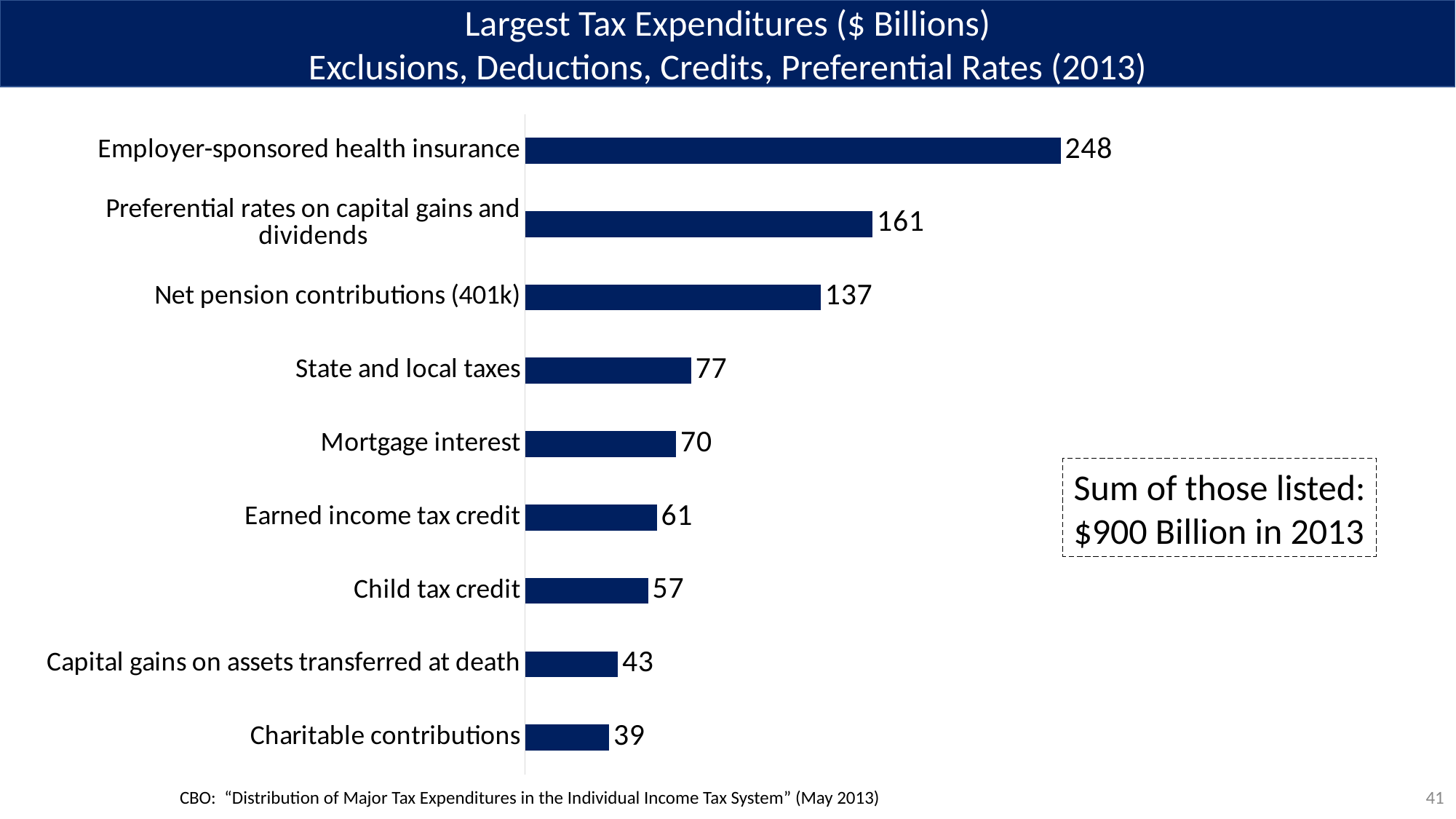
What is the value for Capital gains on assets transferred at death? 43 Which category has the highest value? Employer-sponsored health insurance How many categories are shown in the chart? 9 What is the value for Net pension contributions (401k)? 137 What is the value for Child tax credit? 57 What is the difference between the values for Employer-sponsored health insurance and Preferential rates on capital gains and dividends? 87 What is the value for Employer-sponsored health insurance? 248 Which is larger, the value for Earned income tax credit or the value for Child tax credit? Earned income tax credit What kind of chart is shown on the slide? Bar chart Which category has the lowest value? Charitable contributions What is the difference between the values for State and local taxes and Mortgage interest? 7 According to the text box on the slide, what is the sum of the listed tax expenditures in 2013? $900 Billion